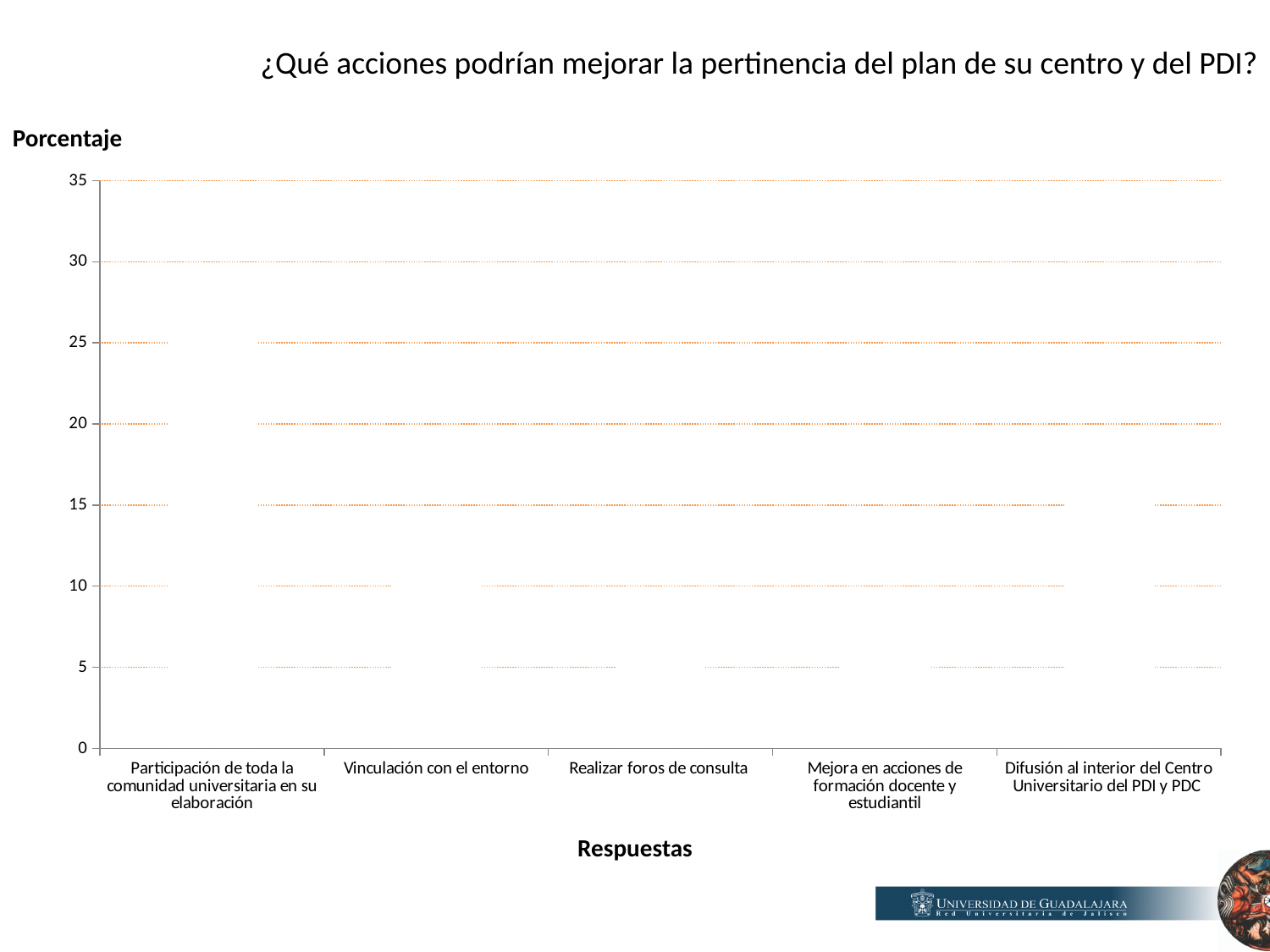
What kind of chart is shown on the slide? bar chart How many response categories are shown on the x axis? 5 What is the label of the horizontal axis? Respuestas Which is larger, the value for 'Difusión al interior del Centro Universitario del PDI y PDC' or the value for 'Vinculación con el entorno'? Difusión al interior del Centro Universitario del PDI y PDC Is the value for 'Participación de toda la comunidad universitaria en su elaboración' greater or less than 30? less What is the label of the vertical axis? Porcentaje Is the value for 'Participación de toda la comunidad universitaria en su elaboración' greater or less than 25? greater Is the value for 'Vinculación con el entorno' greater or less than 15? less Which response category has the highest value? Participación de toda la comunidad universitaria en su elaboración